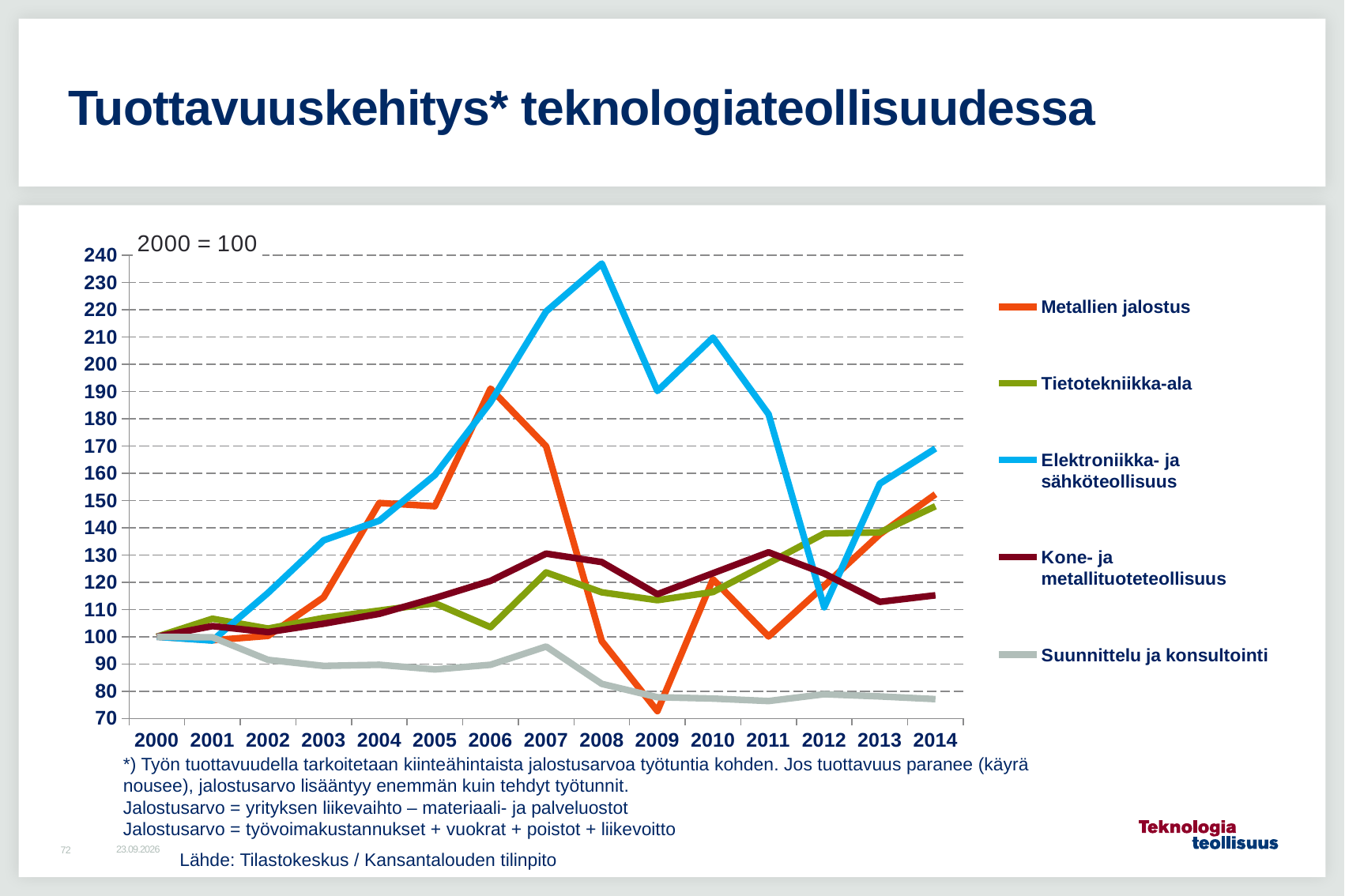
Is the value for Suunnittelu ja konsultointi in 2014 greater or less than 80? less In 2012, which is larger: Tietotekniikka-ala or Elektroniikka- ja sähköteollisuus? Tietotekniikka-ala How many years are shown on the x axis? 15 Is the value for Elektroniikka- ja sähköteollisuus in 2008 greater or less than 220? greater How many series does the legend list? 5 What base-year note is printed above the y axis? 2000 = 100 What is the title of the chart on the slide? Tuottavuuskehitys* teknologiateollisuudessa What kind of chart is shown on the slide? line chart Which series has the highest value in 2008? Elektroniikka- ja sähköteollisuus Which series has the lowest value in 2014? Suunnittelu ja konsultointi Is the value for Metallien jalostus in 2009 greater or less than 80? less Does the Suunnittelu ja konsultointi line rise or fall overall from 2000 to 2014? fall